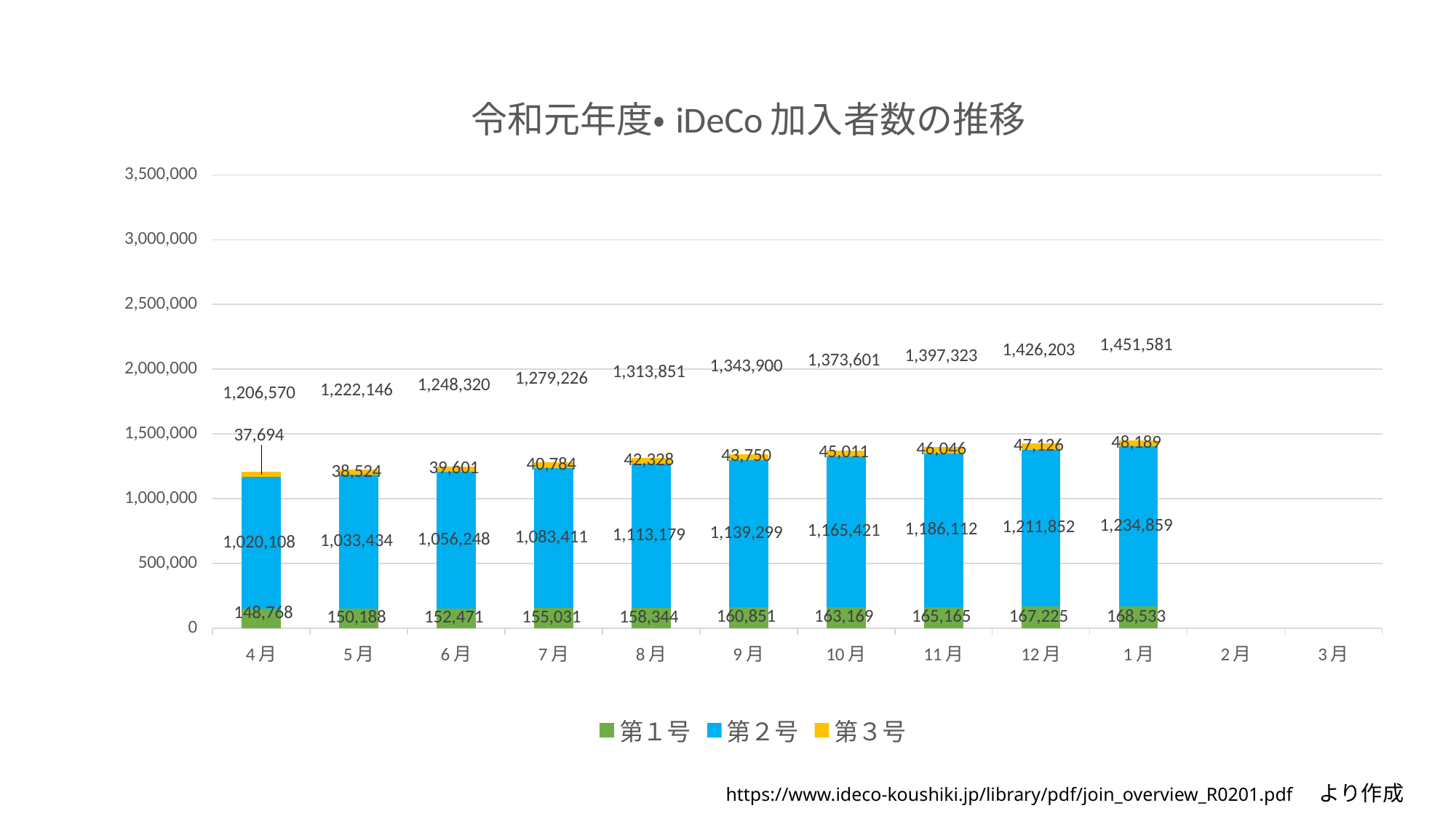
What is the value of 第１号 for 1月? 168,533 Which is larger, the 第２号 value for 7月 or for 8月? 8月 Which month has the lowest value for 第３号? 4月 Do the 第２号 values rise or fall from 4月 to 1月? rise What kind of chart is shown on the slide? stacked bar chart What is the total of the stacked bar for 12月? 1,426,203 How many series does the legend list? 3 Which month has the highest value for 第２号? 1月 What is the value of 第２号 for 4月? 1,020,108 What is the difference between the 第１号 value for 1月 and the 第１号 value for 4月? 19,765 What is the value of 第３号 for 9月? 43,750 How many months are listed on the x axis? 12